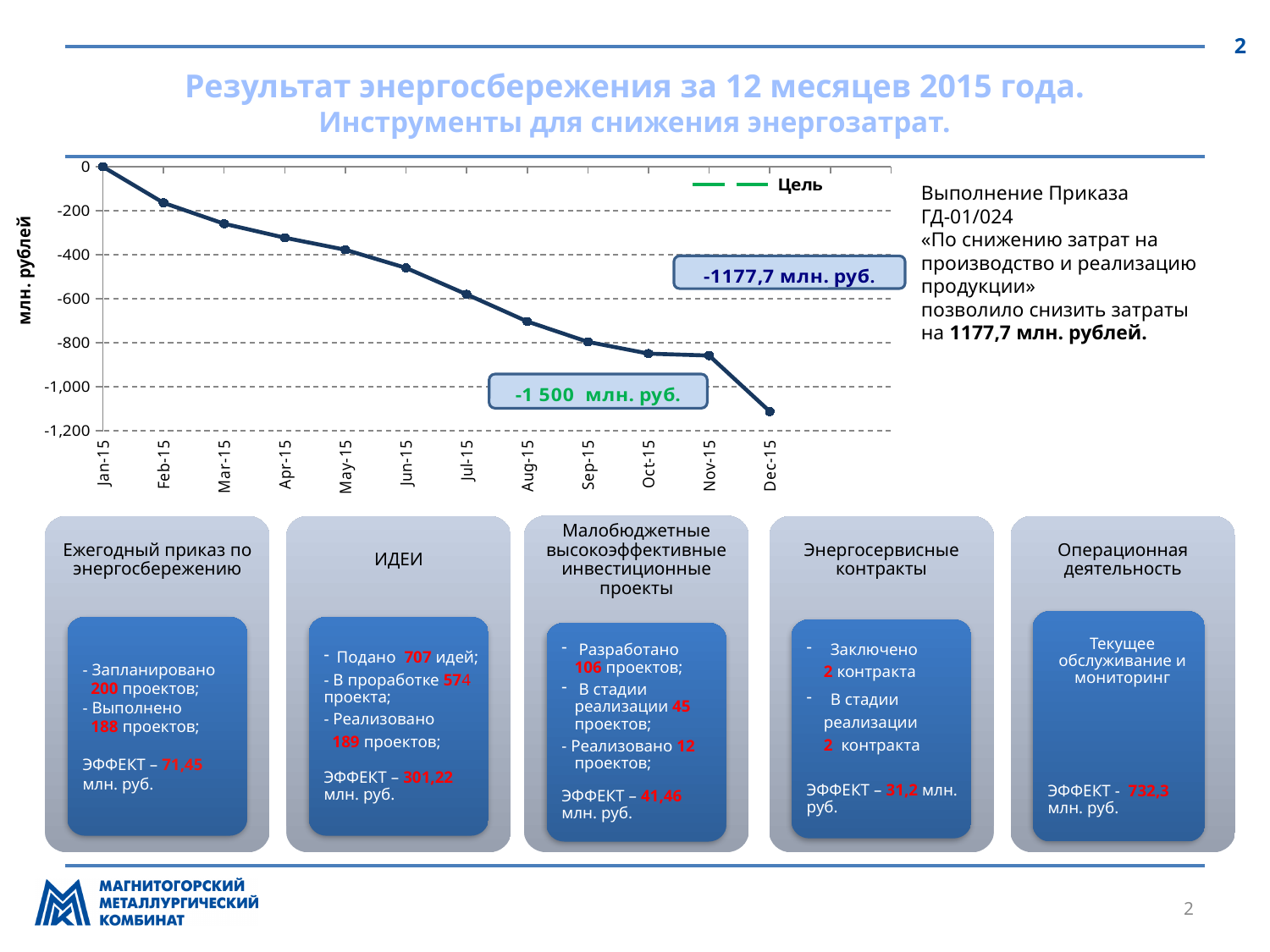
What value is shown in the callout for the end of the line (Dec-15)? -1177,7 млн. руб. What kind of chart is shown on the slide? line chart Which month has the highest value on the line chart? Jan-15 Is the value for Oct-15 above or below -800? below Which month has the lowest value on the line chart? Dec-15 What is the value plotted for Jan-15? 0 What target value (Цель) is shown in the callout on the chart? -1 500 млн. руб. Do the plotted values rise or fall from Jan-15 to Dec-15? fall Is the value for Jun-15 above or below -400? below Is the value for Apr-15 above or below -400? above How many monthly data points are plotted on the line chart? 12 Which is higher on the chart, the value for Feb-15 or the value for Nov-15? Feb-15